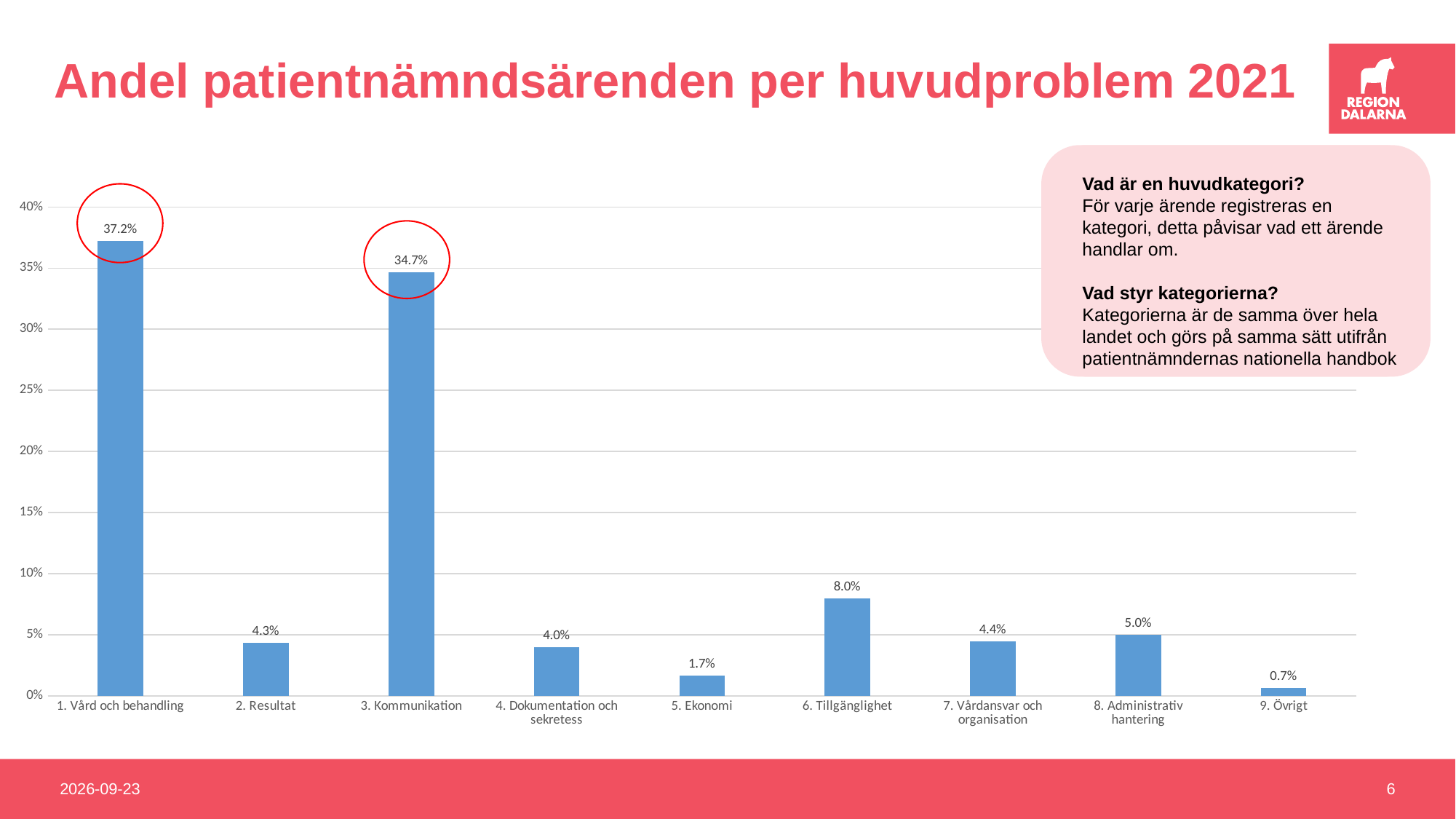
What is the value for 9. Övrigt? 0.7% What is the value for 1. Vård och behandling? 37.2% Which is larger, the value for 2. Resultat or the value for 4. Dokumentation och sekretess? 2. Resultat Is the value for 6. Tillgänglighet greater or less than 10%? less What is the value for 3. Kommunikation? 34.7% What is the value for 6. Tillgänglighet? 8.0% Which category has the highest value? 1. Vård och behandling What kind of chart is shown on the slide? bar chart What is the title of the slide? Andel patientnämndsärenden per huvudproblem 2021 Which category has the lowest value? 9. Övrigt What is the difference between the values for 1. Vård och behandling and 3. Kommunikation? 2.5% How many categories are shown on the x axis? 9